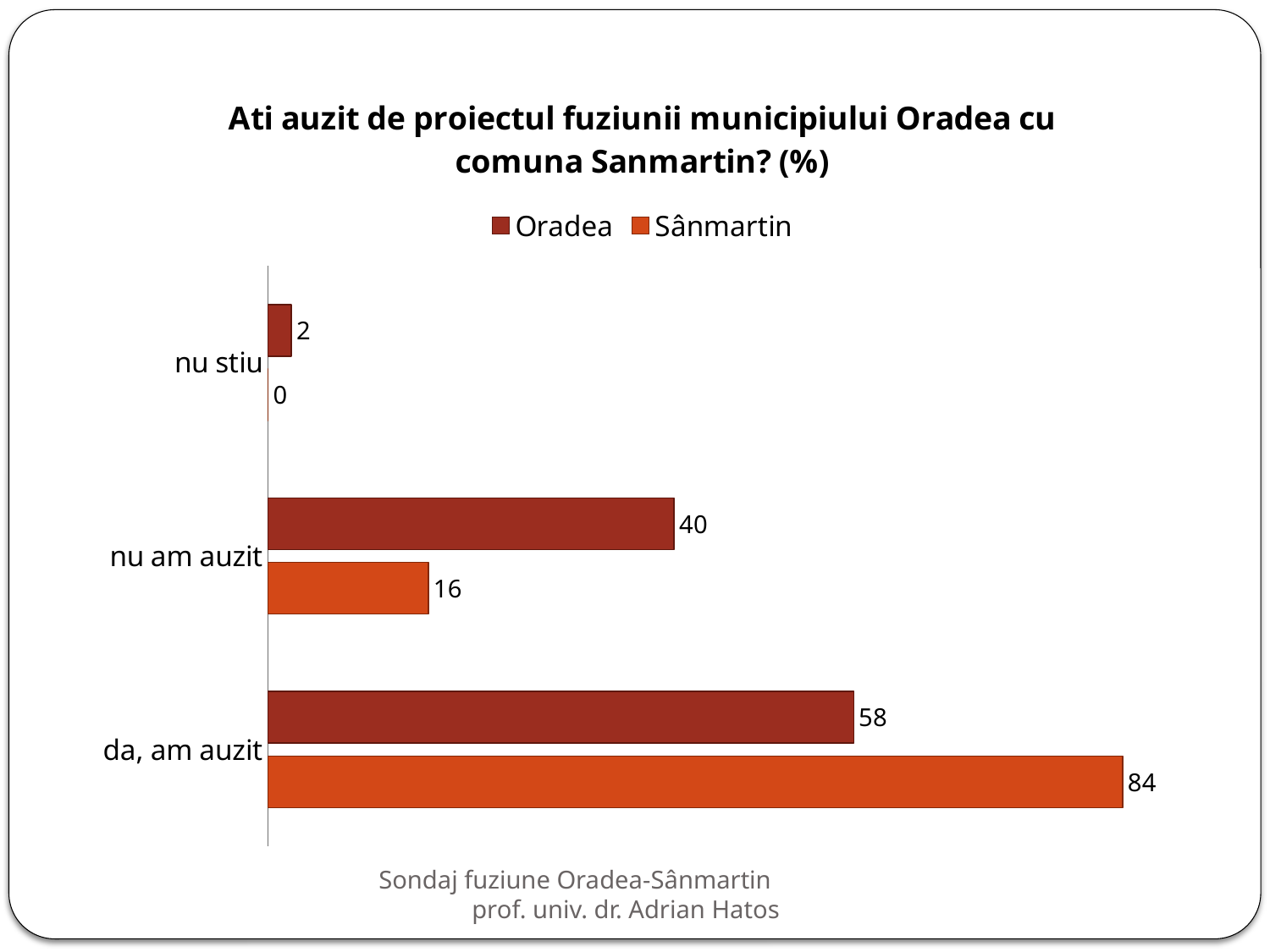
What is the value for Oradea in the "da, am auzit" category? 58 What kind of chart is shown on the slide? bar chart How many categories are shown on the chart? 3 Which category has the highest value for Sânmartin? da, am auzit What is the value for Oradea in the "nu am auzit" category? 40 What is the difference between the Sânmartin and Oradea values for "da, am auzit"? 26 What is the difference between the Oradea and Sânmartin values for "nu am auzit"? 24 What is the value for Sânmartin in the "nu stiu" category? 0 How many series does the legend list? 2 Which is larger for "nu am auzit": Oradea or Sânmartin? Oradea Which category has the lowest value for Oradea? nu stiu What is the value for Sânmartin in the "da, am auzit" category? 84